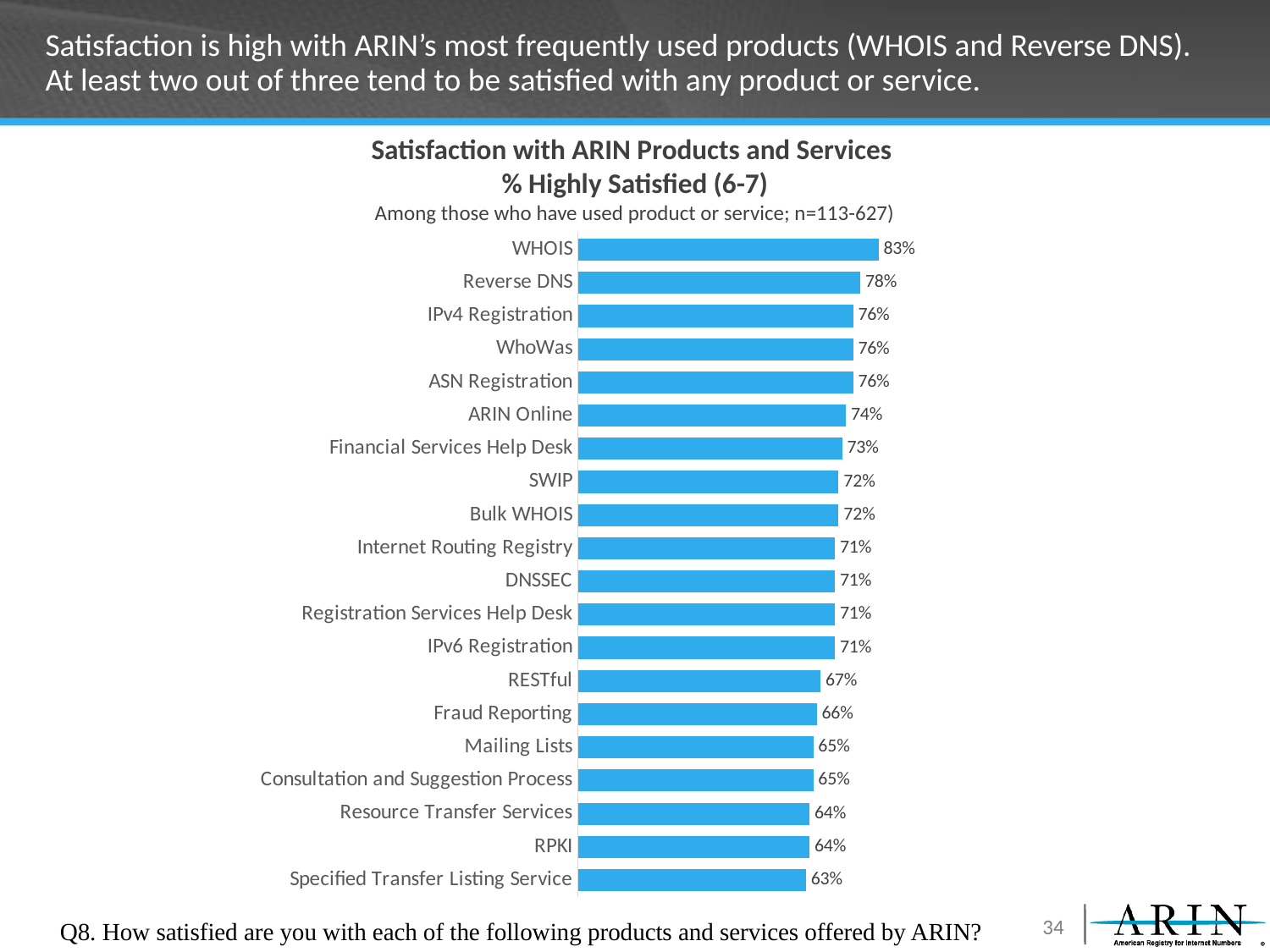
Which has a higher % Highly Satisfied, SWIP or RESTful? SWIP What type of chart is used on this slide? Bar chart Which has a higher % Highly Satisfied, Fraud Reporting or Financial Services Help Desk? Financial Services Help Desk What is the sample size range given in the chart subtitle? n=113-627 How many products and services are shown in the chart? 20 Which product or service has the lowest % Highly Satisfied? Specified Transfer Listing Service Which product or service has the highest % Highly Satisfied? WHOIS What is the % Highly Satisfied value for RPKI? 64% What percentage of users are highly satisfied with WHOIS? 83% What is the difference in % Highly Satisfied between IPv4 Registration and IPv6 Registration? 5% What is the difference in % Highly Satisfied between WHOIS and Reverse DNS? 5% What is the % Highly Satisfied value for ARIN Online? 74%